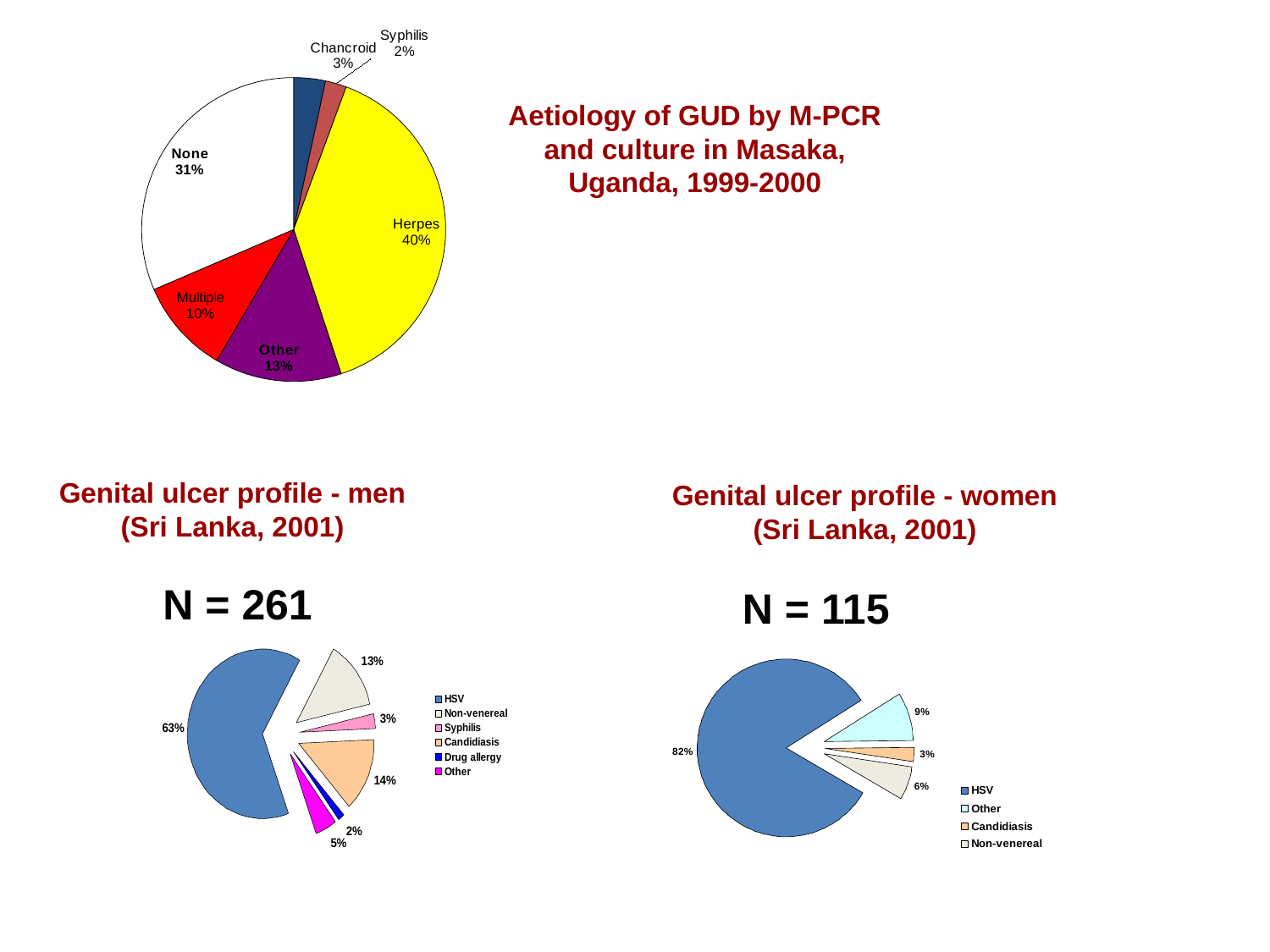
In the 'Genital ulcer profile - women (Sri Lanka, 2001)' chart, what percentage is HSV? 82% What type of chart is used for the 'Genital ulcer profile - women (Sri Lanka, 2001)'? Pie chart In the 'Genital ulcer profile - men (Sri Lanka, 2001)' chart, what percentage is HSV? 63% In the Uganda 'Aetiology of GUD' pie chart, what is the difference in percentage points between Other and Multiple? 3 In the Uganda 'Aetiology of GUD' pie chart, which category has the smallest share? Syphilis How many slices does the Uganda 'Aetiology of GUD' pie chart have? 6 In the Uganda 'Aetiology of GUD' pie chart, what percentage is labelled None? 31% In the Uganda 'Aetiology of GUD by M-PCR and culture' pie chart, what percentage is Herpes? 40% How many entries does the legend of the 'Genital ulcer profile - men (Sri Lanka, 2001)' chart list? 6 In the 'Genital ulcer profile - women (Sri Lanka, 2001)' chart, what is the difference in percentage points between Other and Candidiasis? 6 In the 'Genital ulcer profile - men (Sri Lanka, 2001)' chart, which is larger, Non-venereal or Syphilis? Non-venereal In the 'Genital ulcer profile - men (Sri Lanka, 2001)' chart, what percentage is Candidiasis? 14%